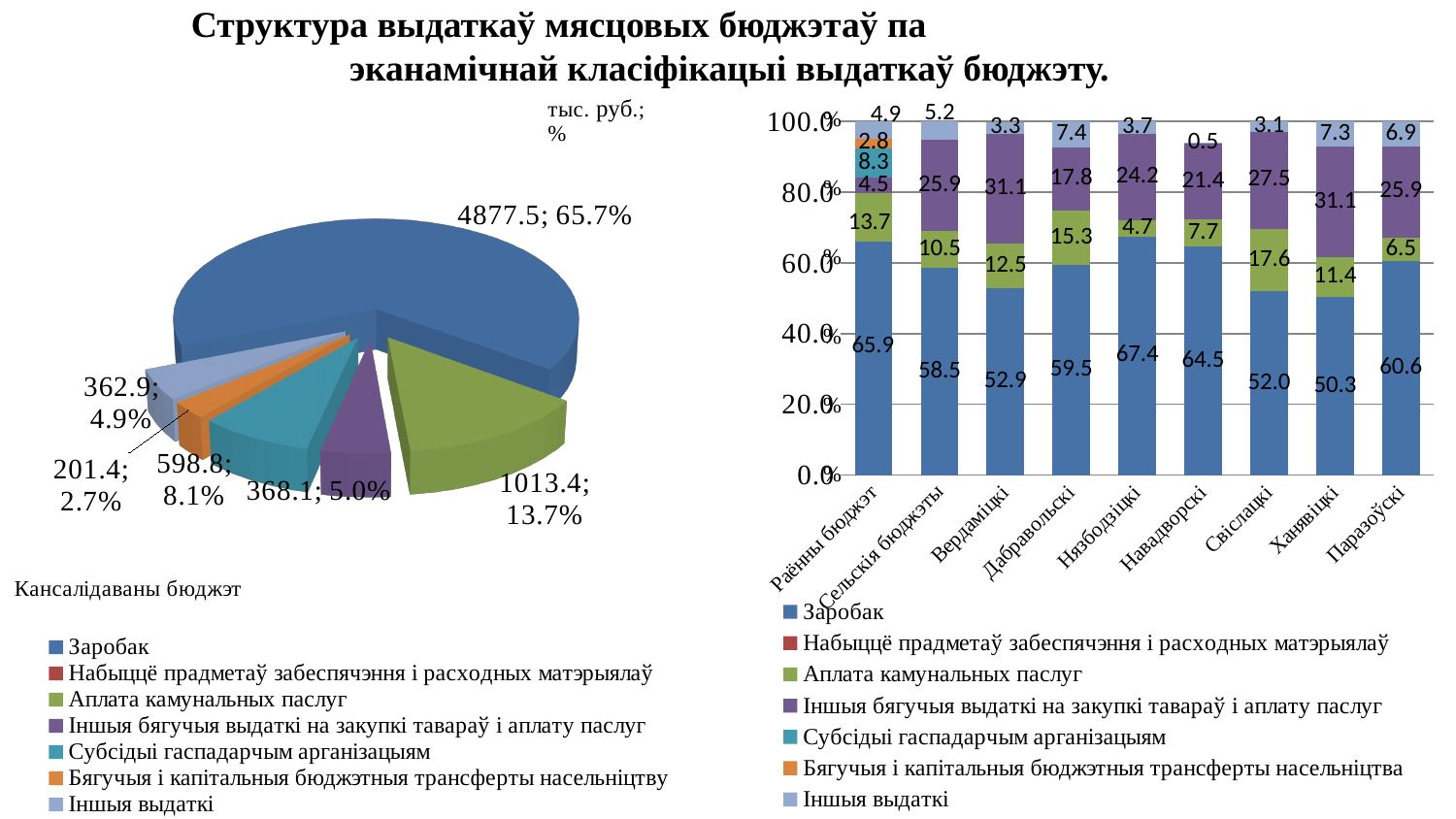
In the stacked bar chart on the right, how many budget categories are shown on the x axis? 9 In the stacked bar chart on the right, what is the Заробак value for Нязбодзіцкі? 67.4 In the pie chart on the left, what is the difference between the values for Аплата камунальных паслуг and Субсідыі гаспадарчым арганізацыям? 414.6 In the pie chart on the left, which slice is the smallest? Бягучыя і капітальныя бюджэтныя трансферты насельніцтву (201.4; 2.7%) In the stacked bar chart on the right, which is larger: the Заробак value for Раённы бюджэт or for Сельскія бюджэты? Раённы бюджэт In the pie chart on the left, what share does the Аплата камунальных паслуг slice have? 13.7% In the stacked bar chart on the right, which category has the lowest Заробак value? Ханявіцкі In the pie chart on the left, what is the value shown for Субсідыі гаспадарчым арганізацыям? 598.8 What kind of chart is on the right side of the slide? Stacked bar chart In the stacked bar chart on the right, how many series does the legend list? 7 In the stacked bar chart on the right, what is the Іншыя бягучыя выдаткі на закупкі тавараў і аплату паслуг value for Вердаміцкі? 31.1 In the pie chart on the left, what value and share are shown for the Заробак slice? 4877.5; 65.7%